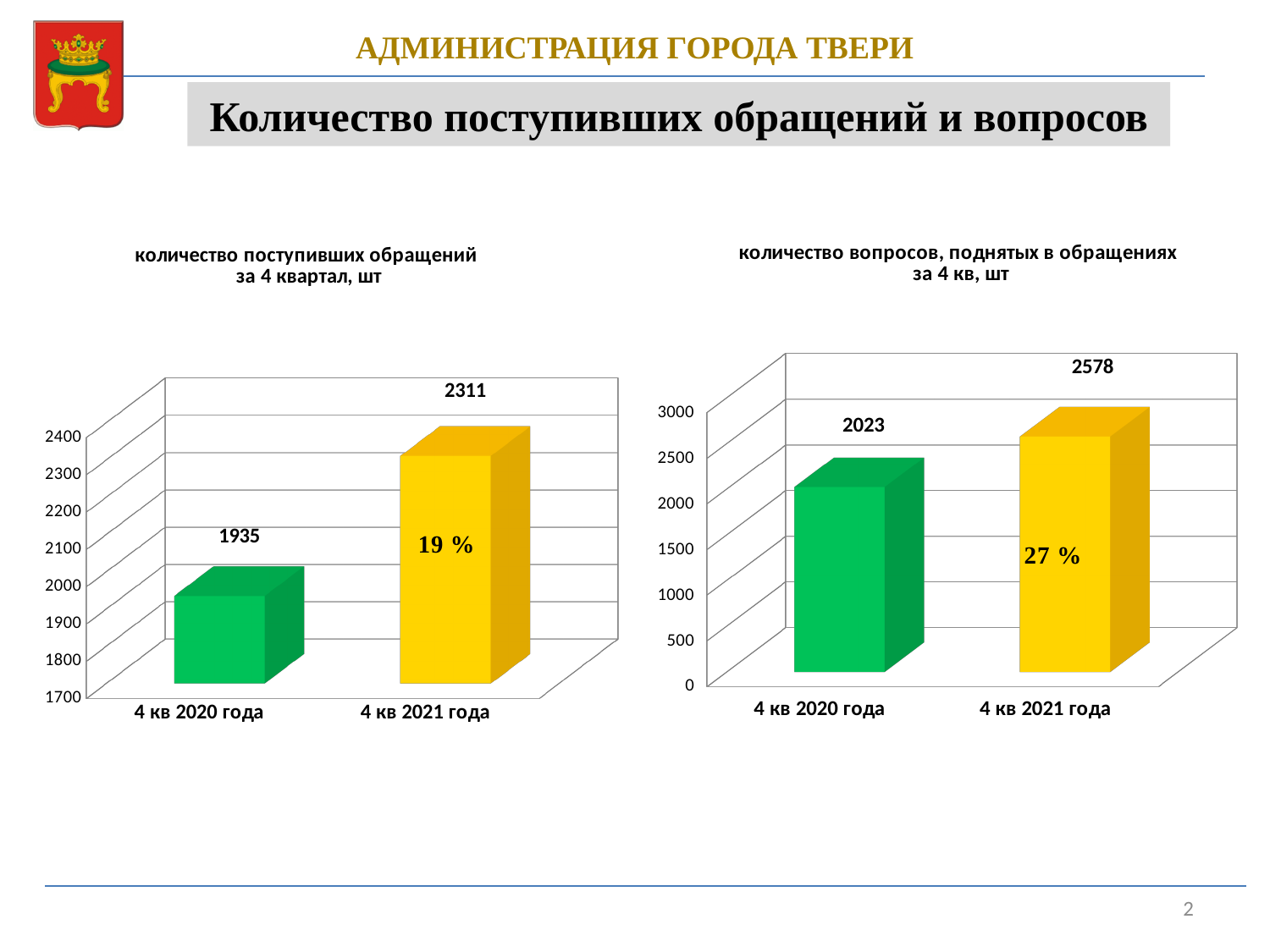
In the right chart (количество вопросов, поднятых в обращениях за 4 кв, шт), what is the value for 4 кв 2020 года? 2023 How many categories are shown in the left chart? 2 In the left chart (количество поступивших обращений за 4 квартал, шт), what is the value for 4 кв 2020 года? 1935 In the left chart, what percentage label is printed on the bar for 4 кв 2021 года? 19 % In the left chart, which category has the highest value? 4 кв 2021 года In the right chart, what is the difference between the values for 4 кв 2021 года and 4 кв 2020 года? 555 In the right chart, is the value for 4 кв 2020 года greater or less than 2500? less What kind of chart is the right chart? bar chart In the left chart (количество поступивших обращений за 4 квартал, шт), what is the value for 4 кв 2021 года? 2311 In the right chart, which category has the lowest value? 4 кв 2020 года In the left chart, what is the difference between the values for 4 кв 2021 года and 4 кв 2020 года? 376 In the right chart (количество вопросов, поднятых в обращениях за 4 кв, шт), what is the value for 4 кв 2021 года? 2578